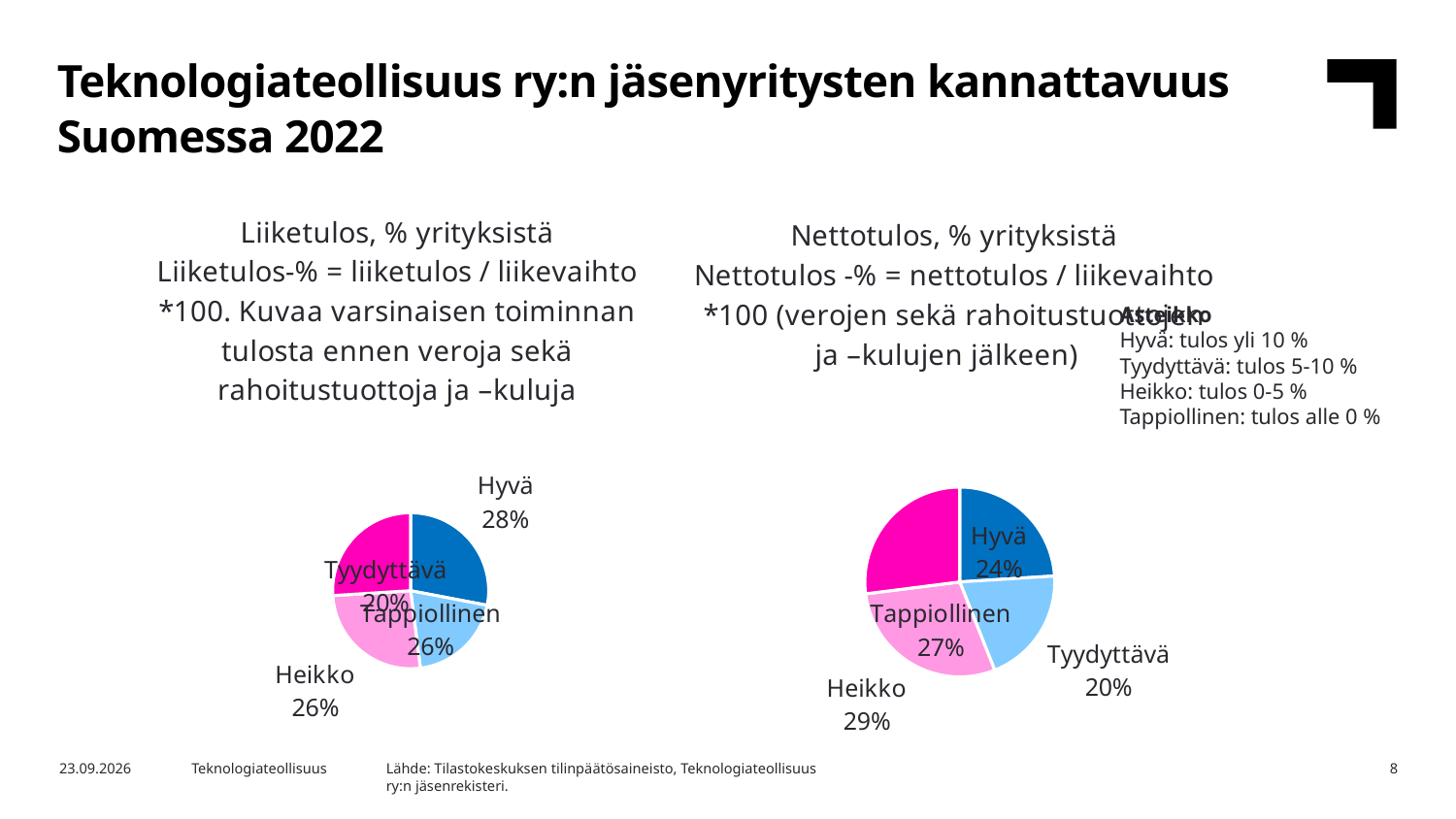
In the Nettotulos, % yrityksistä chart, what share of companies is labelled Heikko? 29% In the Nettotulos, % yrityksistä chart, which category has the largest share? Heikko What type of chart is used for Liiketulos, % yrityksistä? Pie chart In the Nettotulos, % yrityksistä chart, what share of companies is labelled Tappiollinen? 27% In the Liiketulos, % yrityksistä chart, what share of companies is labelled Tyydyttävä? 20% Is the Hyvä share larger in the Liiketulos chart or in the Nettotulos chart? Liiketulos How many categories does the Nettotulos, % yrityksistä pie chart have? 4 In the Nettotulos, % yrityksistä chart, which category has the smallest share? Tyydyttävä In the Liiketulos, % yrityksistä chart, which category has the largest share? Hyvä In the Liiketulos, % yrityksistä chart, what share of companies is labelled Hyvä? 28% In the Liiketulos, % yrityksistä chart, which category has the smallest share? Tyydyttävä In the Nettotulos, % yrityksistä chart, what is the difference between the Heikko and Hyvä shares? 5 percentage points